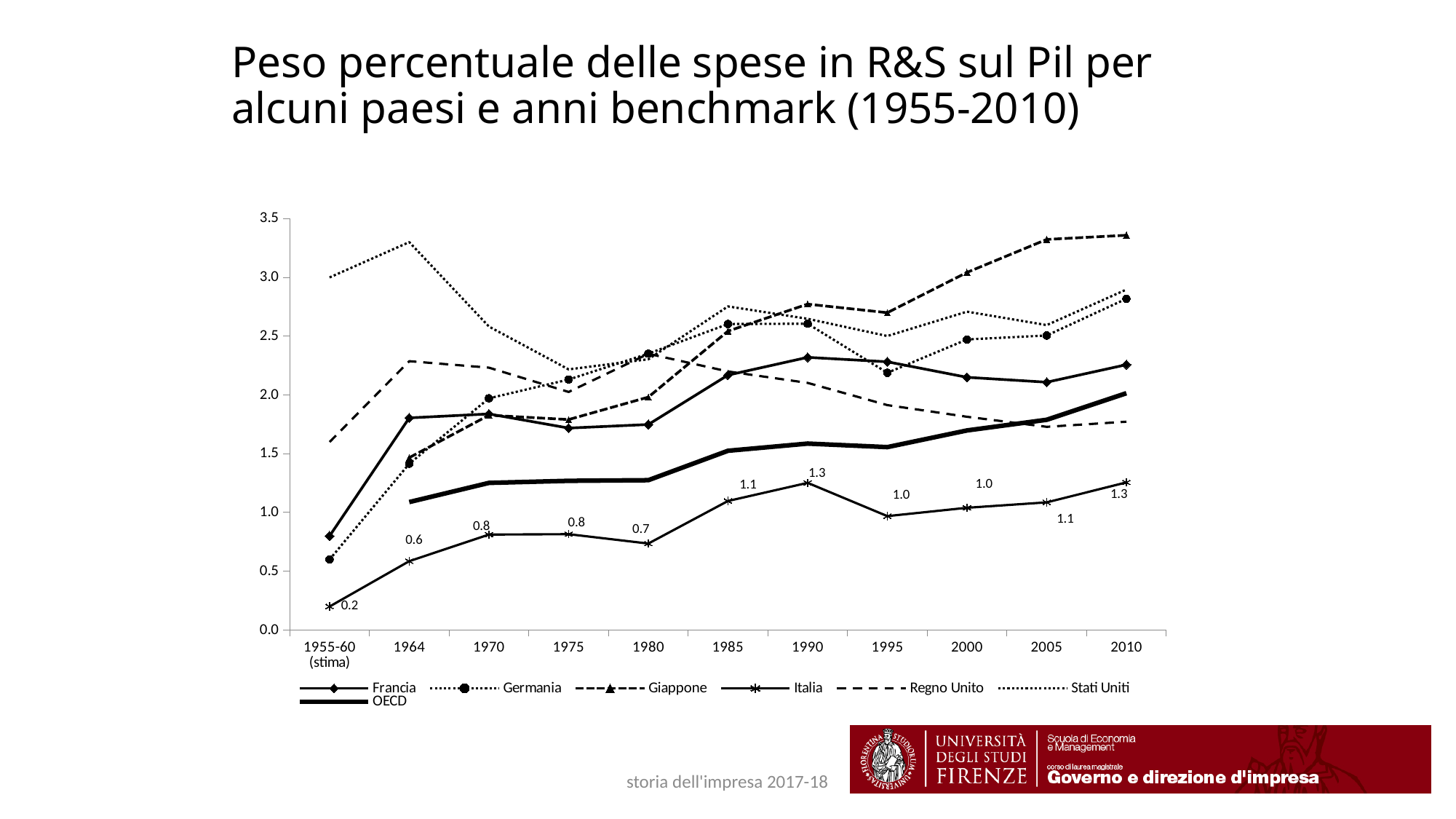
How many series does the legend list? 7 Which is larger in 1964, the value for Stati Uniti or the value for Francia? Stati Uniti Does the Italia series overall rise or fall from 1955-60 (stima) to 2010? rise What is the difference between the Italia value in 2010 and in 1955-60 (stima)? 1.1 Which series has the lowest value in 2010? Italia What is the value for Italia in 1980? 0.7 Which series has the highest value in 2010? Giappone What is the value for Italia in 1955-60 (stima)? 0.2 Is the value for Giappone in 2010 greater or less than 3.0? greater What is the value for Italia in 1990? 1.3 How many benchmark periods are shown on the x axis? 11 What kind of chart is shown on the slide? line chart